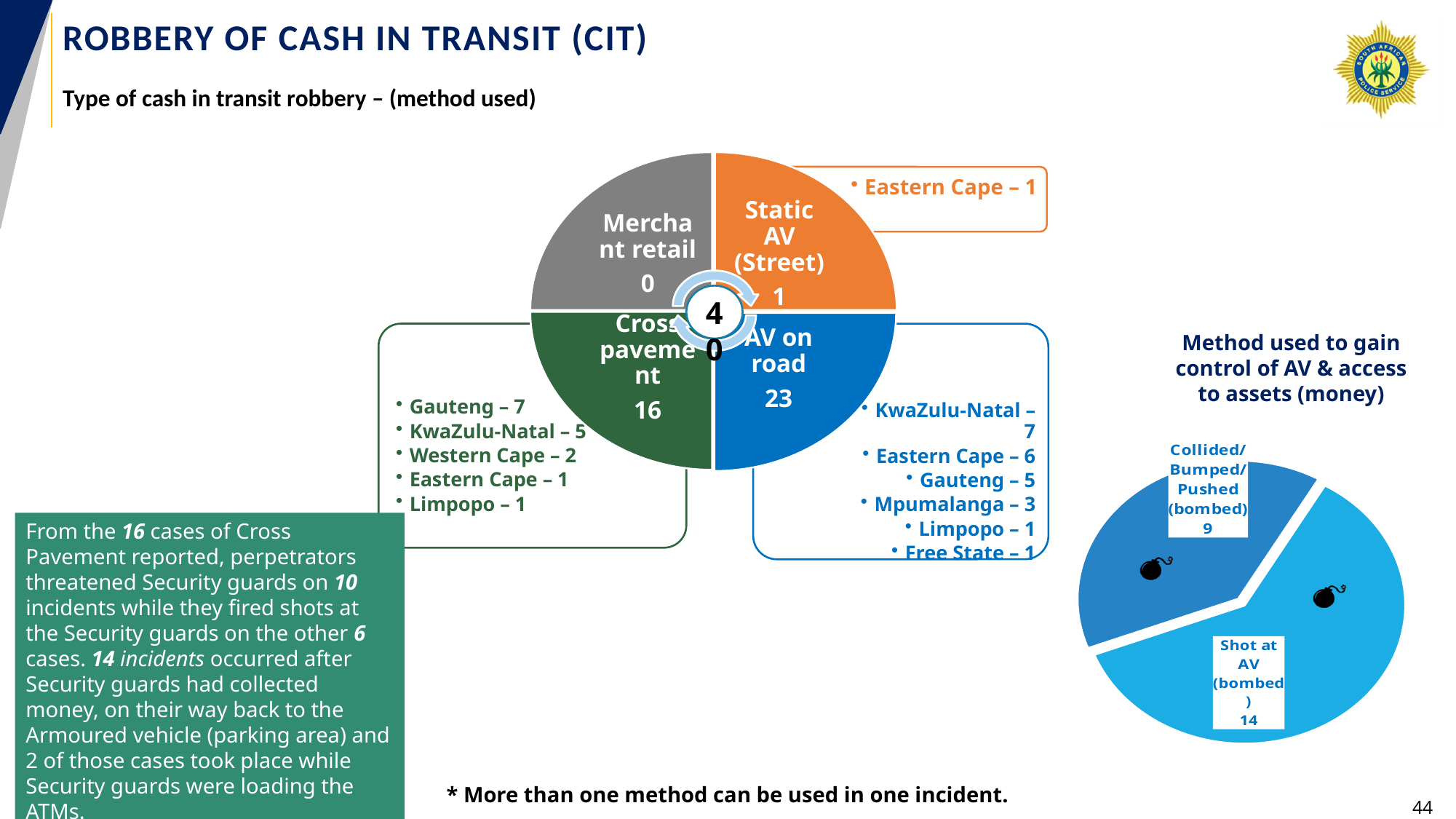
In the 'Type of cash in transit robbery' pie chart, how many cases are shown for Merchant retail? 0 In the 'Method used to gain control of AV & access to assets (money)' chart, how many cases are shown for Collided/Bumped/Pushed (bombed)? 9 In the 'Type of cash in transit robbery' pie chart, how many cases are shown for AV on road? 23 In the 'Method used to gain control of AV & access to assets (money)' chart, which method has more cases, Shot at AV (bombed) or Collided/Bumped/Pushed (bombed)? Shot at AV (bombed) In the 'Type of cash in transit robbery' pie chart, which category has the highest number of cases? AV on road How many categories does the 'Type of cash in transit robbery' pie chart show? 4 In the 'Method used to gain control of AV & access to assets (money)' chart, how many cases are shown for Shot at AV (bombed)? 14 In the 'Type of cash in transit robbery' pie chart, what is the difference between the AV on road and Cross pavement cases? 7 What kind of chart is the 'Method used to gain control of AV & access to assets (money)' chart? Pie chart In the 'Type of cash in transit robbery' pie chart, what total number is shown in the centre of the pie? 40 In the 'Type of cash in transit robbery' pie chart, how many cases are shown for Cross pavement? 16 In the 'Type of cash in transit robbery' pie chart, which category has the lowest number of cases? Merchant retail